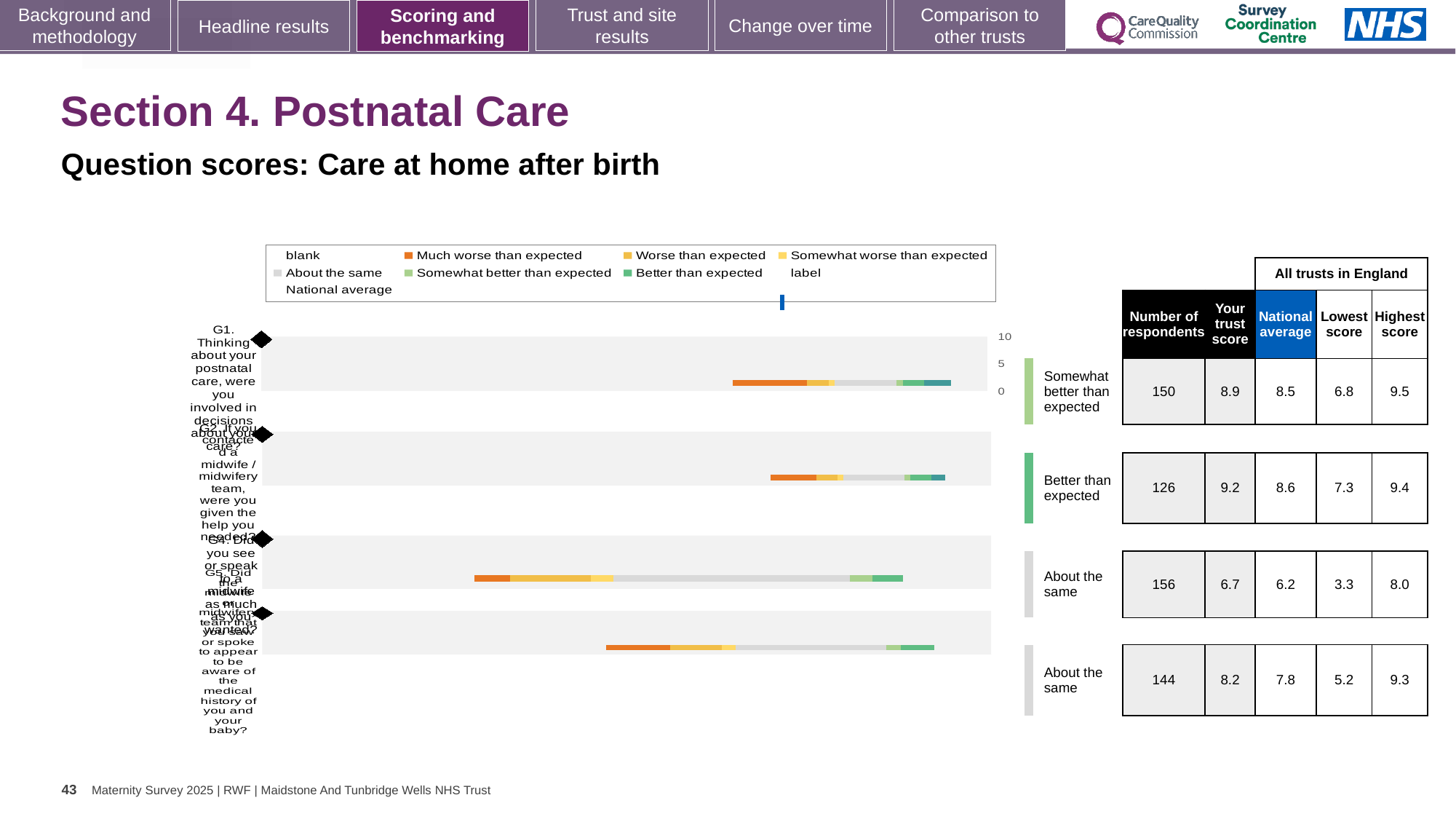
How many entries does the chart legend list? 9 What is the highest score across all trusts in England for question G5 in the table next to the chart? 9.3 Is the trust score for question G4 higher or lower than the national average for G4? higher How many questions (bars) are plotted in the chart? 4 What is the 'Your trust score' for question G1 in the table next to the chart? 8.9 Which question has the highest 'Your trust score' in the table next to the chart? G2 What is the difference between the trust score and the national average for question G1? 0.4 What kind of chart is shown on the slide? bar chart What is the national average for question G2 in the table next to the chart? 8.6 Which question has the lowest 'Your trust score' in the table next to the chart? G4 What benchmark category is shown for question G2 (the second bar) in the chart? Better than expected How many respondents are listed for question G4 in the table next to the chart? 156